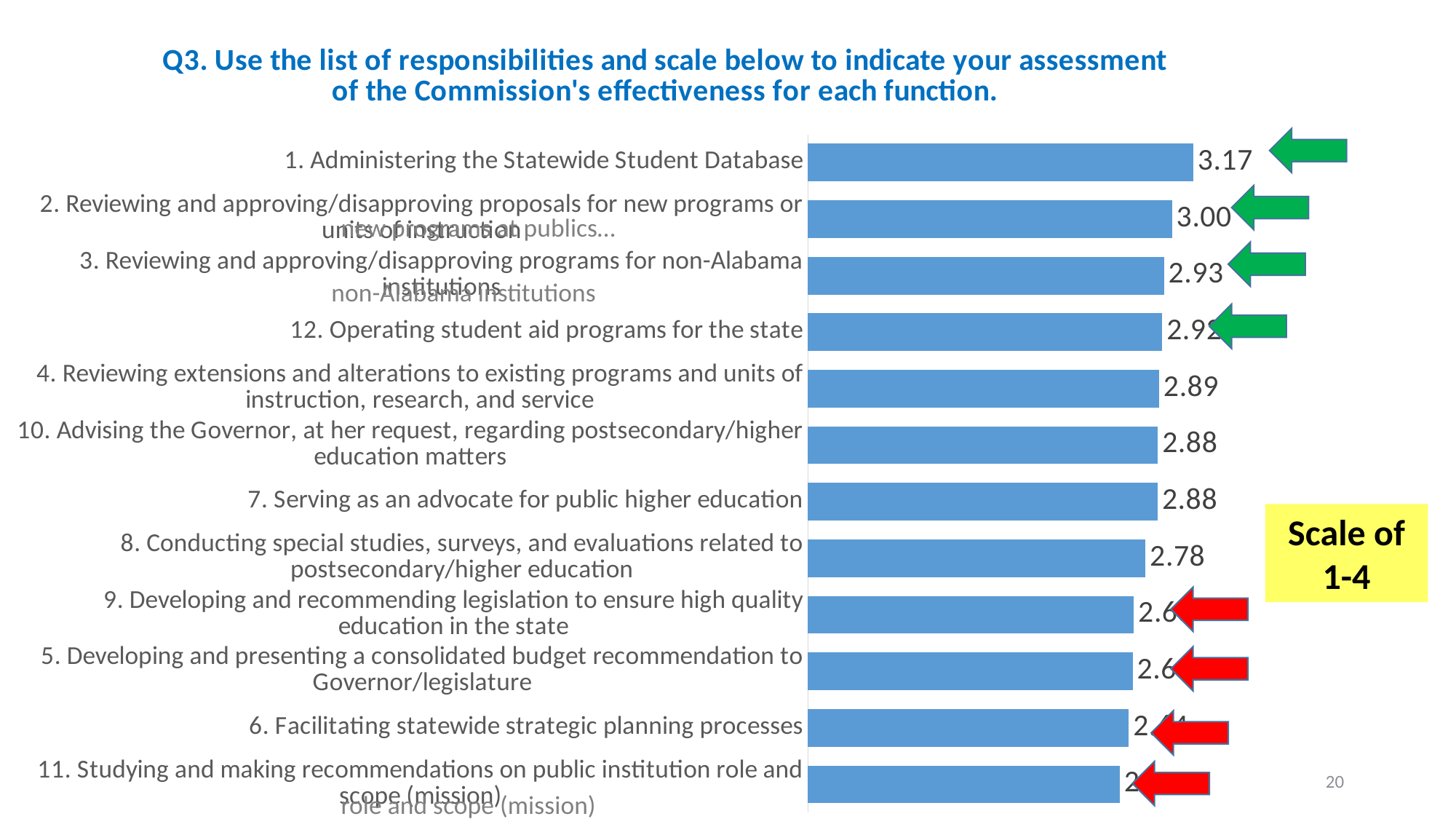
What is the value for "1. Administering the Statewide Student Database"? 3.17 According to the yellow note on the slide, what scale are the values measured on? Scale of 1-4 What is the value for "8. Conducting special studies, surveys, and evaluations related to postsecondary/higher education"? 2.78 Which has a larger value: "2. Reviewing and approving/disapproving proposals for new programs or units of instruction" or "3. Reviewing and approving/disapproving programs for non-Alabama institutions"? 2. Reviewing and approving/disapproving proposals for new programs or units of instruction What is the difference between the values for "1. Administering the Statewide Student Database" and "8. Conducting special studies, surveys, and evaluations related to postsecondary/higher education"? 0.39 What is the difference between the values for "1. Administering the Statewide Student Database" and "2. Reviewing and approving/disapproving proposals for new programs or units of instruction"? 0.17 What is the value for "4. Reviewing extensions and alterations to existing programs and units of instruction, research, and service"? 2.89 How many responsibilities are plotted in the chart? 12 What is the value for "7. Serving as an advocate for public higher education"? 2.88 Which responsibility has the highest value? 1. Administering the Statewide Student Database What kind of chart is shown on the slide? Bar chart Which responsibility has the lowest value? 11. Studying and making recommendations on public institution role and scope (mission)